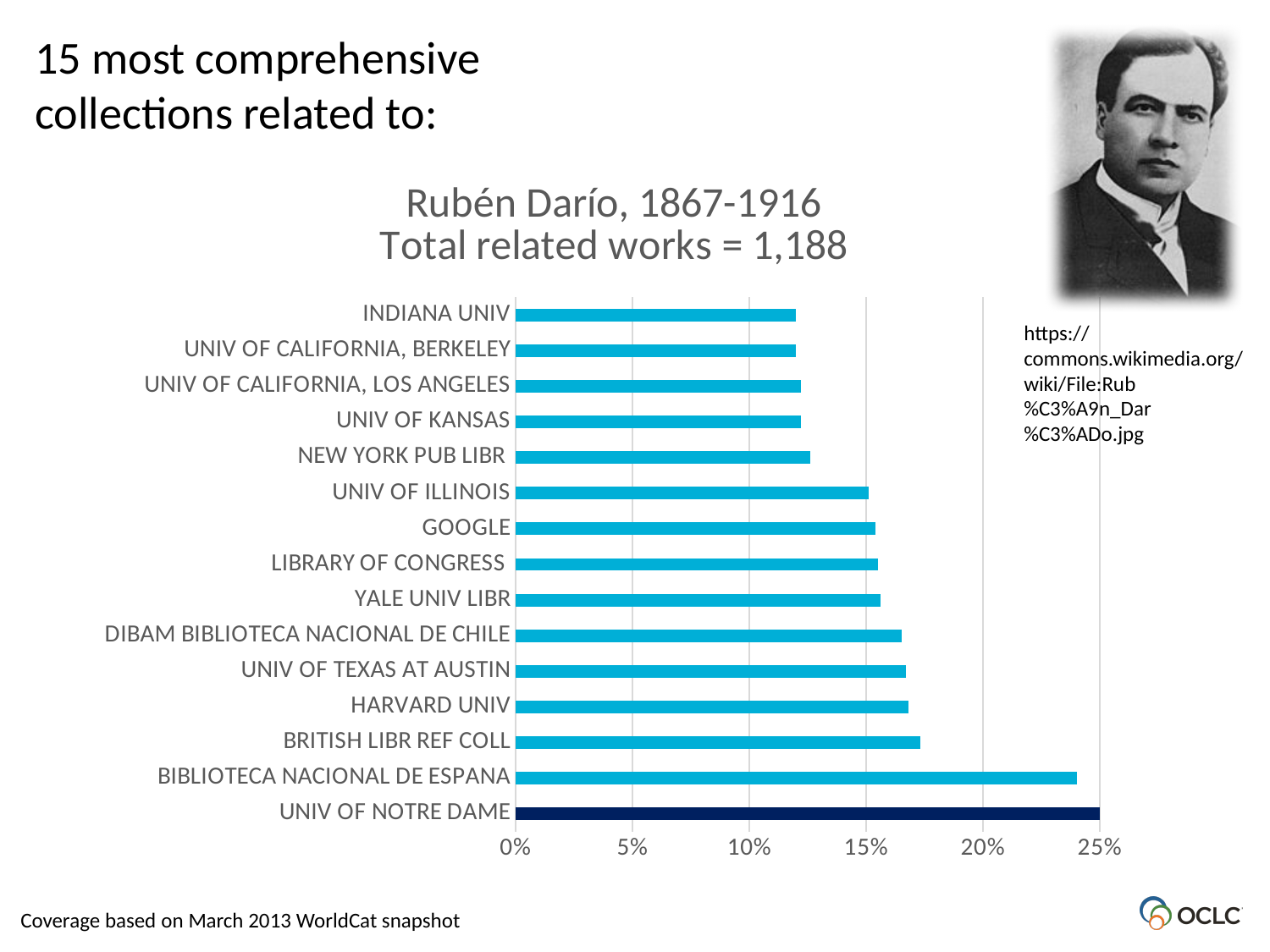
How many collections (categories) are plotted in the chart? 15 Is the value for INDIANA UNIV greater or less than 15%? less Is the value for BIBLIOTECA NACIONAL DE ESPANA greater or less than 20%? greater Is the value for UNIV OF KANSAS greater or less than 10%? greater According to the chart title, what is the total number of related works? 1,188 Which has the larger value, UNIV OF NOTRE DAME or HARVARD UNIV? UNIV OF NOTRE DAME What kind of chart is shown on the slide? bar chart Which has the larger value, UNIV OF ILLINOIS or NEW YORK PUB LIBR? UNIV OF ILLINOIS Which bar in the chart is shown in a different (dark blue) colour from the others? UNIV OF NOTRE DAME Which has the larger value, BIBLIOTECA NACIONAL DE ESPANA or BRITISH LIBR REF COLL? BIBLIOTECA NACIONAL DE ESPANA Which collection has the highest value in the chart? UNIV OF NOTRE DAME